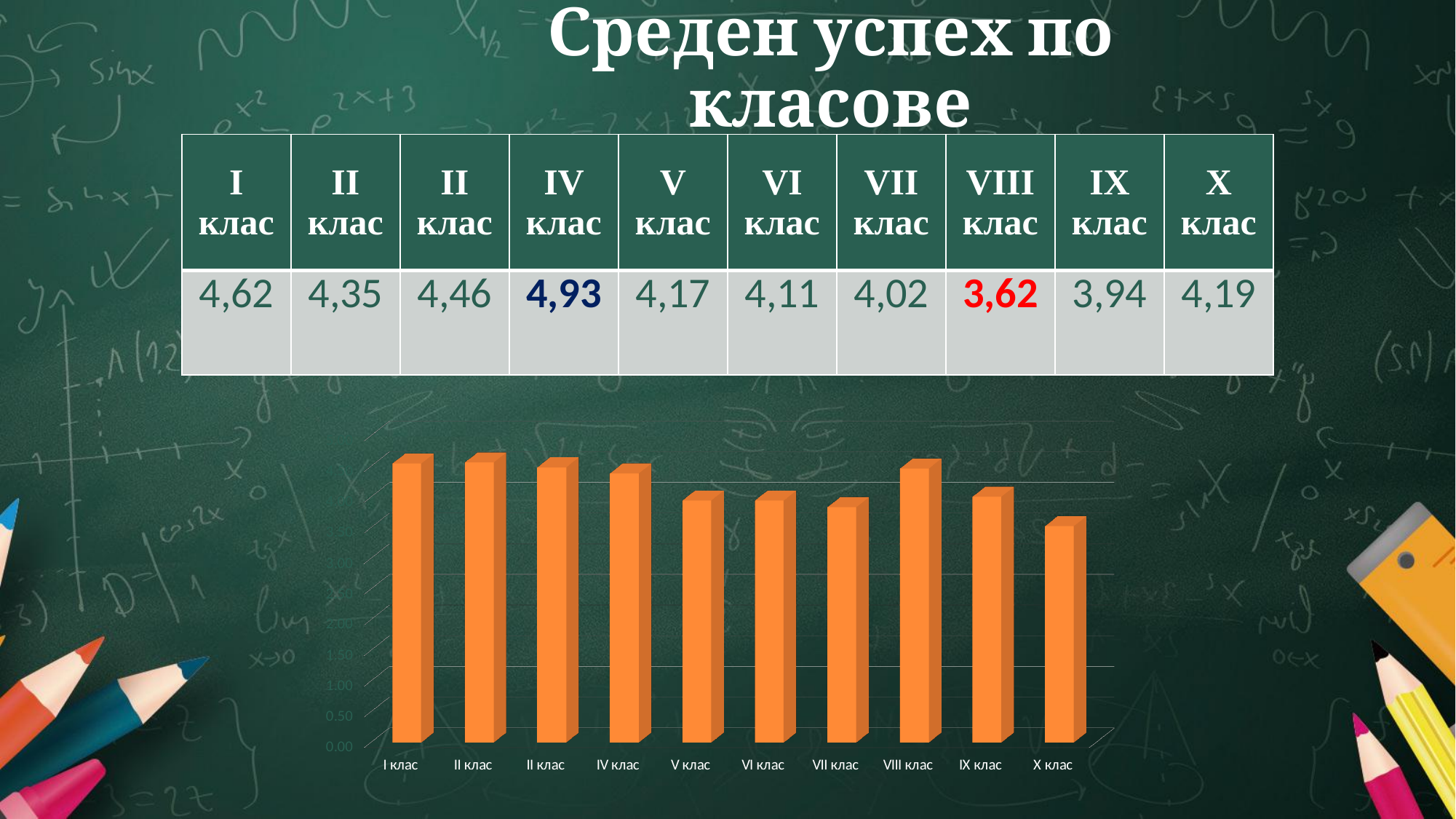
What is the label of the first category on the x axis of the chart? I клас Which bar is taller in the chart, V клас or X клас? V клас What kind of chart is shown on the slide? bar chart Is the bar for I клас greater or less than 2.00? greater Which class has the lowest bar in the chart? X клас Which bar is taller in the chart, I клас or X клас? I клас How many bars (classes) does the chart show? 10 Is the bar for VII клас greater or less than 3.00? greater Is the bar for X клас greater or less than 3.00? greater Which bar is taller in the chart, VIII клас or VII клас? VIII клас What colour are the bars in the chart? orange